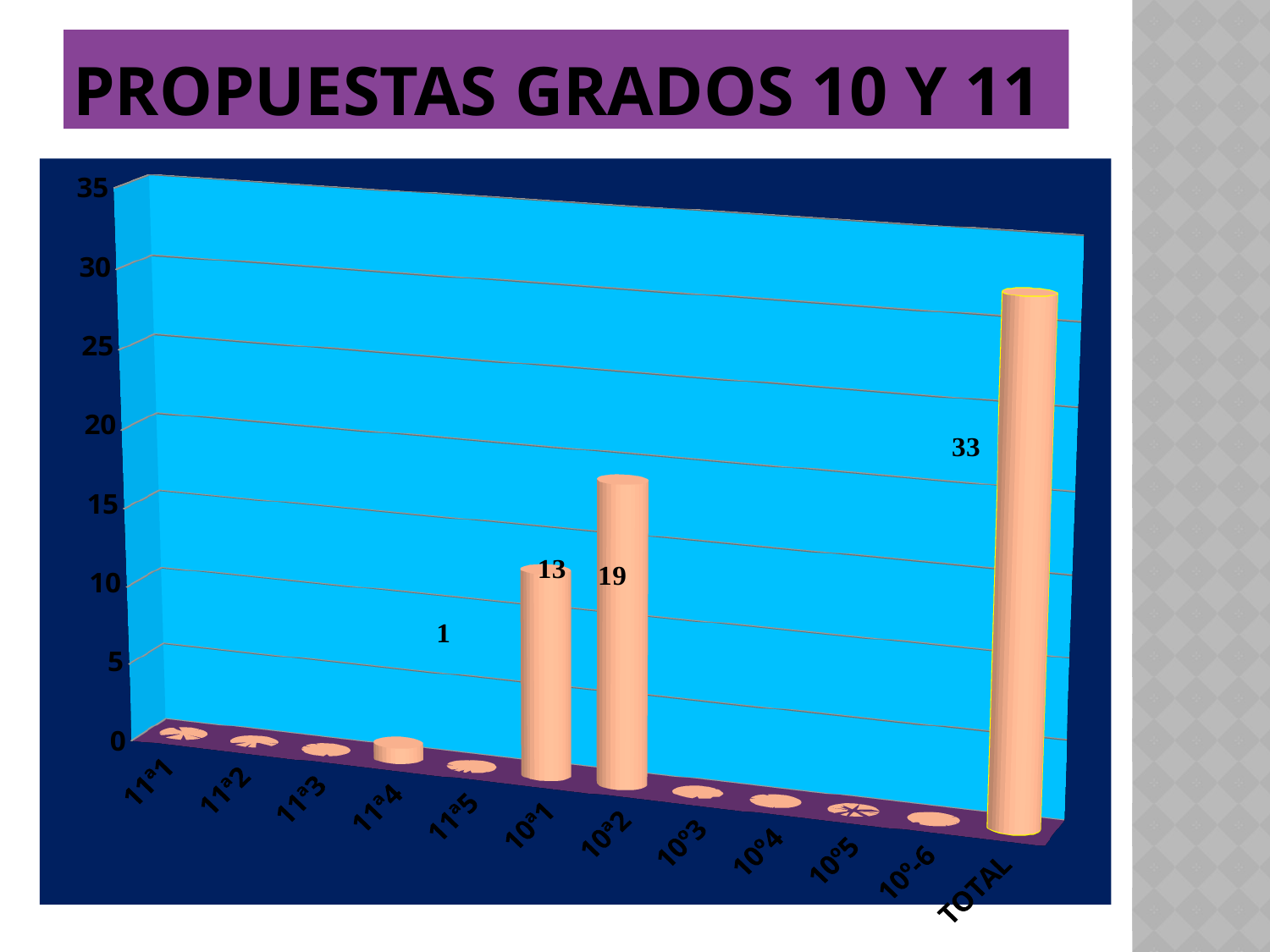
What kind of chart is shown on the slide? bar chart Which category has the highest value? TOTAL How many categories are shown on the x axis? 12 What is the difference between the values for 10ª2 and 10ª1? 6 What is the value for 10ª1? 13 Is the value for TOTAL greater or less than 30? greater What is the title of the slide? PROPUESTAS GRADOS 10 Y 11 What is the value for 10ª2? 19 What is the difference between the values for TOTAL and 10ª2? 14 What is the value for TOTAL? 33 What is the value for 11ª4? 1 Which is larger, the value for 10ª1 or the value for 10ª2? 10ª2